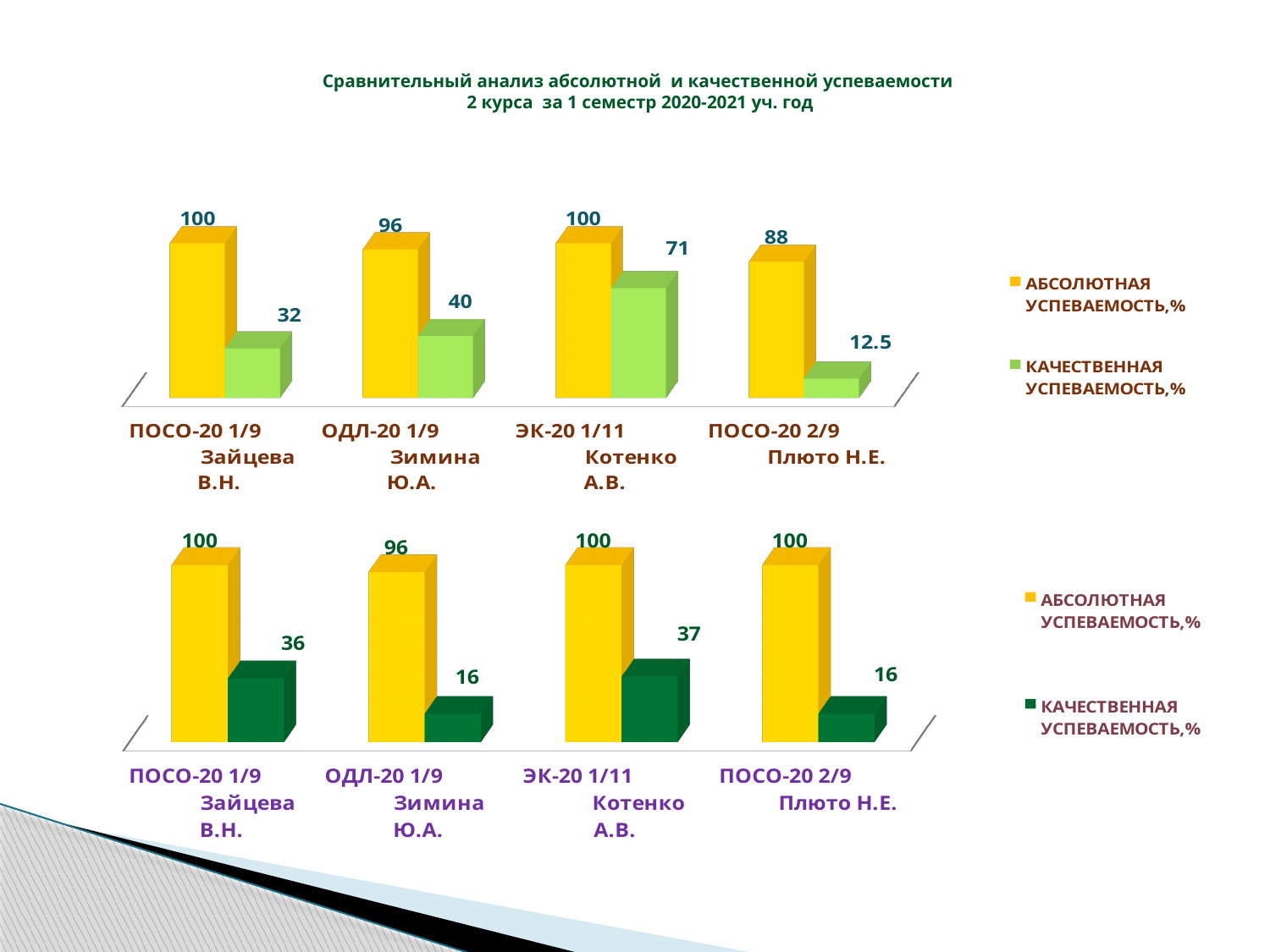
In the bottom chart, what is the value of КАЧЕСТВЕННАЯ УСПЕВАЕМОСТЬ,% for ПОСО-20 1/9 Зайцева В.Н.? 36 In the bottom chart, what is the difference in КАЧЕСТВЕННАЯ УСПЕВАЕМОСТЬ,% between ЭК-20 1/11 Котенко А.В. and ПОСО-20 2/9 Плюто Н.Е.? 21 How many categories are shown in the top chart? 4 In the top chart, what is the difference between АБСОЛЮТНАЯ and КАЧЕСТВЕННАЯ УСПЕВАЕМОСТЬ,% for ОДЛ-20 1/9 Зимина Ю.А.? 56 How many series does the legend of the bottom chart list? 2 In the bottom chart, which category has the highest КАЧЕСТВЕННАЯ УСПЕВАЕМОСТЬ,%? ЭК-20 1/11 Котенко А.В. What type of chart is the top chart? Bar chart In the bottom chart, which category has the lowest АБСОЛЮТНАЯ УСПЕВАЕМОСТЬ,%? ОДЛ-20 1/9 Зимина Ю.А. In the top chart, what is the value of АБСОЛЮТНАЯ УСПЕВАЕМОСТЬ,% for ПОСО-20 2/9 Плюто Н.Е.? 88 In the top chart, what is the value of КАЧЕСТВЕННАЯ УСПЕВАЕМОСТЬ,% for ЭК-20 1/11 Котенко А.В.? 71 In the bottom chart, is КАЧЕСТВЕННАЯ УСПЕВАЕМОСТЬ,% higher for ПОСО-20 1/9 Зайцева В.Н. or for ОДЛ-20 1/9 Зимина Ю.А.? ПОСО-20 1/9 Зайцева В.Н. In the top chart, which category has the lowest КАЧЕСТВЕННАЯ УСПЕВАЕМОСТЬ,%? ПОСО-20 2/9 Плюто Н.Е.